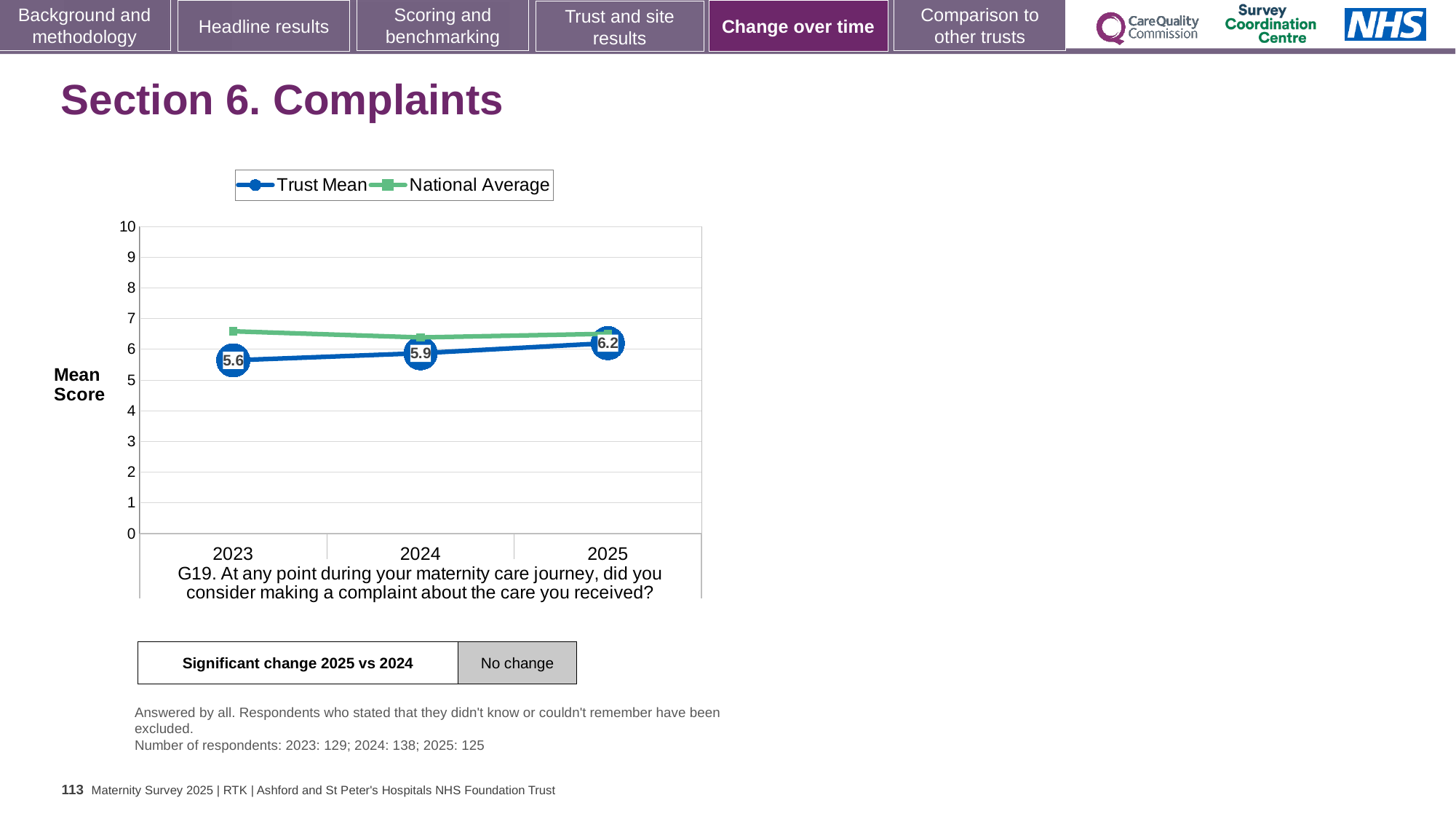
In 2023, which is larger: the Trust Mean or the National Average? National Average Does the Trust Mean rise or fall from 2023 to 2025? Rise What kind of chart is shown on the slide? Line chart In which year is the Trust Mean score highest? 2025 What is the difference between the Trust Mean score in 2025 and in 2023? 0.6 Is the National Average value for 2023 greater or less than 6? greater What is the Trust Mean score for 2023? 5.6 In which year is the Trust Mean score lowest? 2023 How many series does the legend list? 2 How many years are plotted on the x axis? 3 What is the Trust Mean score for 2024? 5.9 What is the Trust Mean score for 2025? 6.2